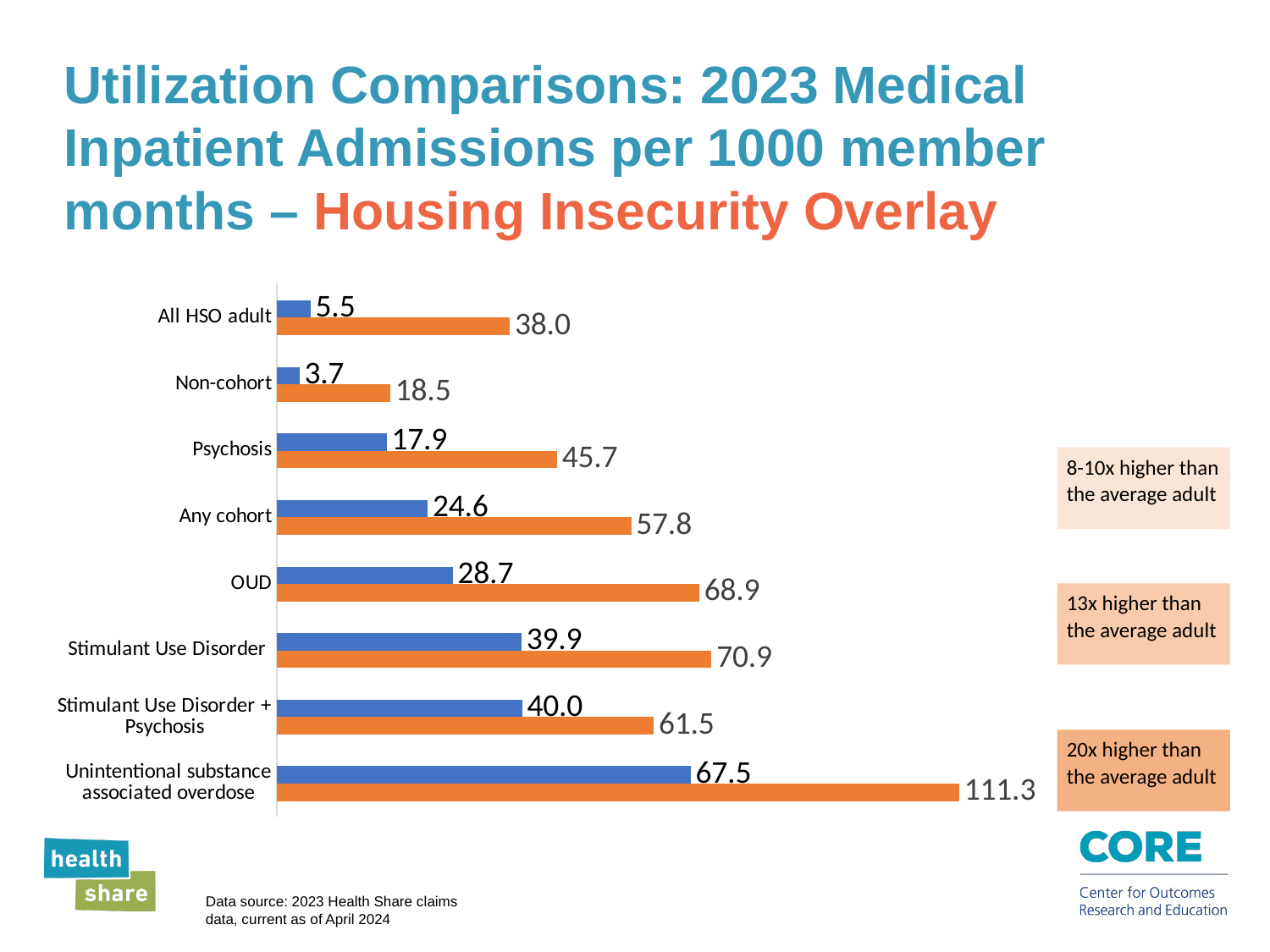
Which category has the lowest blue bar value? Non-cohort What is the value of the orange bar for Unintentional substance associated overdose? 111.3 According to the annotation next to the chart, how many times higher than the average adult is the Unintentional substance associated overdose group? 20x What is the value of the orange bar for Non-cohort? 18.5 Which is larger: the orange bar for Stimulant Use Disorder or the orange bar for Stimulant Use Disorder + Psychosis? Stimulant Use Disorder What is the difference between the orange bar and the blue bar for OUD? 40.2 What kind of chart is shown on the slide? Bar chart How many categories are shown on the chart? 8 Which category has the highest orange bar value? Unintentional substance associated overdose What is the value of the blue bar for Psychosis? 17.9 What is the value of the blue bar for Stimulant Use Disorder + Psychosis? 40.0 What is the difference between the orange bar values for All HSO adult and Non-cohort? 19.5